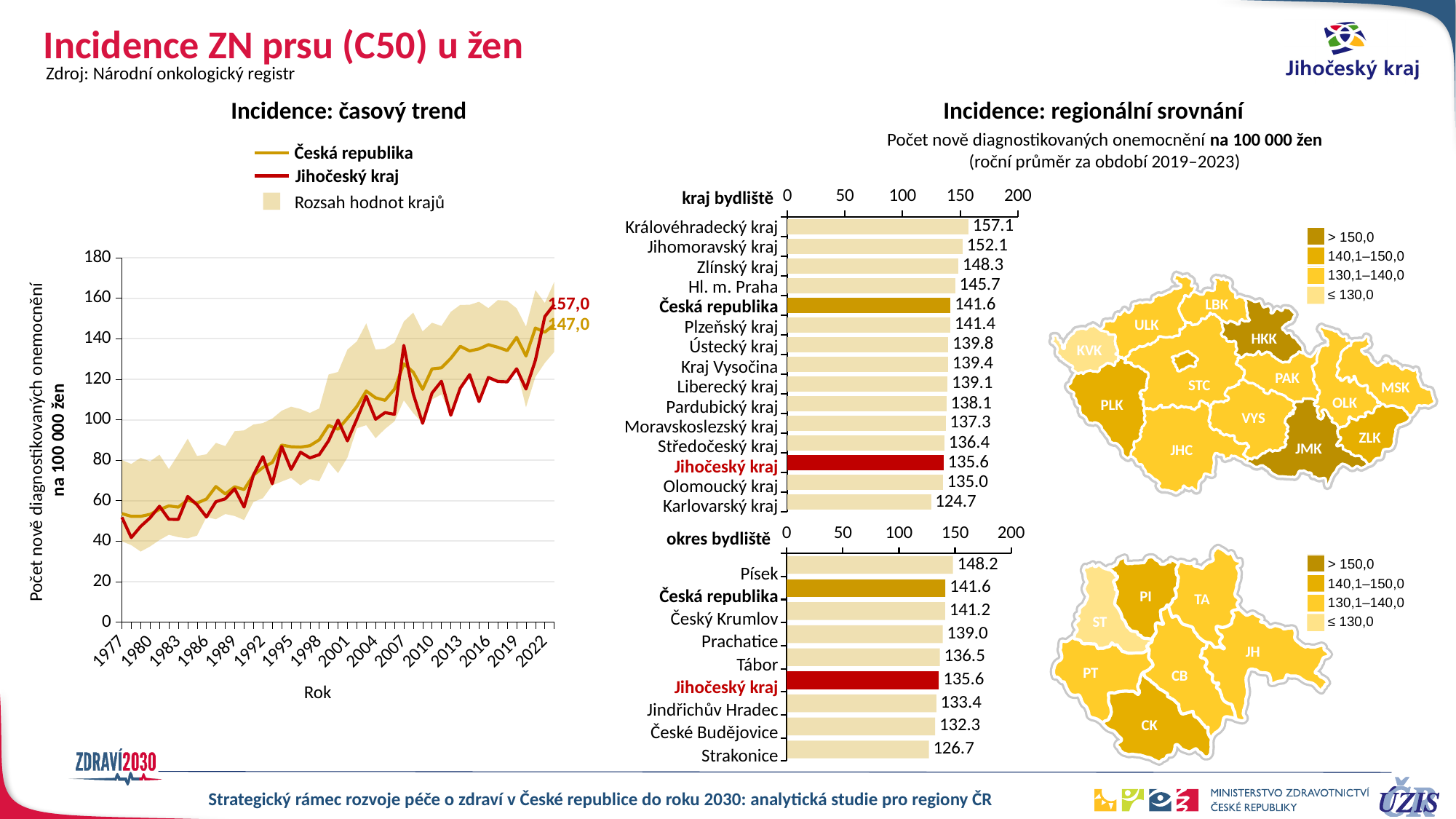
How many bars are shown in the 'kraj bydliště' bar chart? 15 In the 'okres bydliště' bar chart, what is the difference between Písek and Strakonice? 21.5 How many entries does the legend of the 'Incidence: časový trend' chart list? 3 In the 'kraj bydliště' bar chart, which region has the highest value? Královéhradecký kraj In the 'okres bydliště' bar chart, which is larger, Tábor or Prachatice? Prachatice In the 'okres bydliště' bar chart, which district has the lowest value? Strakonice In the 'okres bydliště' bar chart, what is the value for Písek? 148.2 In the 'Incidence: časový trend' chart, what is the final labelled value for Jihočeský kraj? 157,0 In the 'kraj bydliště' bar chart, which region has the lowest value? Karlovarský kraj In the 'kraj bydliště' bar chart, what is the value for Královéhradecký kraj? 157.1 In the 'Incidence: časový trend' chart, do the values generally rise or fall from 1977 to 2022? rise In the 'kraj bydliště' bar chart, what is the difference between Královéhradecký kraj and Karlovarský kraj? 32.4